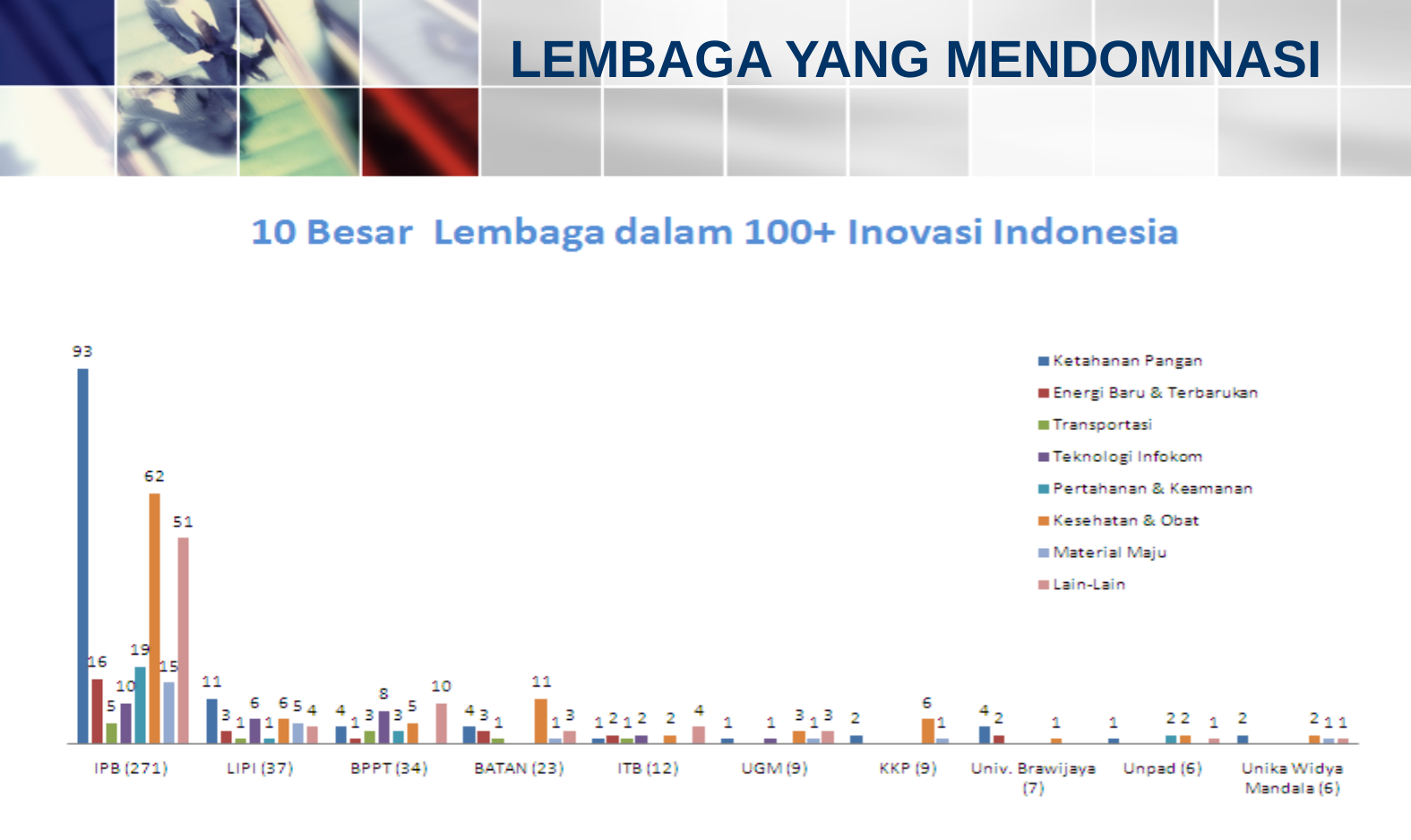
What is the Ketahanan Pangan value for IPB (271)? 93 What is the Kesehatan & Obat value for BATAN (23)? 11 What is the title of the chart? 10 Besar Lembaga dalam 100+ Inovasi Indonesia For IPB (271), which is larger: Pertahanan & Keamanan or Energi Baru & Terbarukan? Pertahanan & Keamanan What is the Kesehatan & Obat value for IPB (271)? 62 How many series does the legend list? 8 What is the difference between the Ketahanan Pangan value and the Kesehatan & Obat value for IPB (271)? 31 What is the difference between the Kesehatan & Obat value and the Lain-Lain value for IPB (271)? 11 What kind of chart is shown on the slide? bar chart How many institutions (categories) are shown on the x axis? 10 Which institution has the highest Ketahanan Pangan value? IPB (271) What is the Lain-Lain value for BPPT (34)? 10